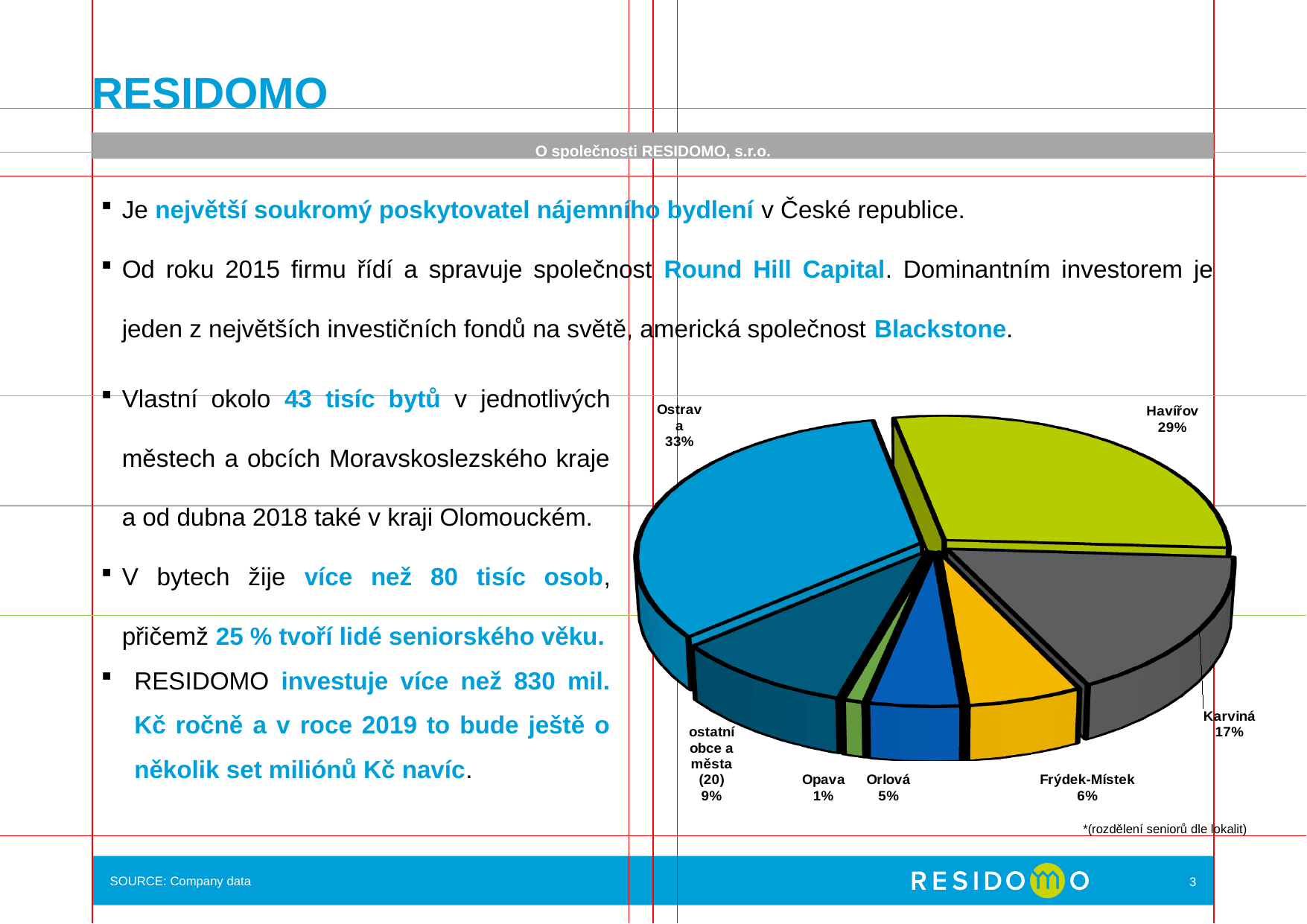
What is the combined share of Karviná and Orlová? 22% What share of the pie does Karviná have? 17% What share of the pie does Frýdek-Místek have? 6% What share of the pie does Havířov have? 29% How many slices does the pie chart have? 7 What share of the pie does Ostrava have? 33% What share of the pie does Opava have? 1% Which slice of the pie chart is the largest? Ostrava What kind of chart is shown on the slide? pie chart Which is larger, the share for Orlová or the share for Frýdek-Místek? Frýdek-Místek What is the difference in percentage points between Ostrava and Havířov? 4 Which slice of the pie chart is the smallest? Opava